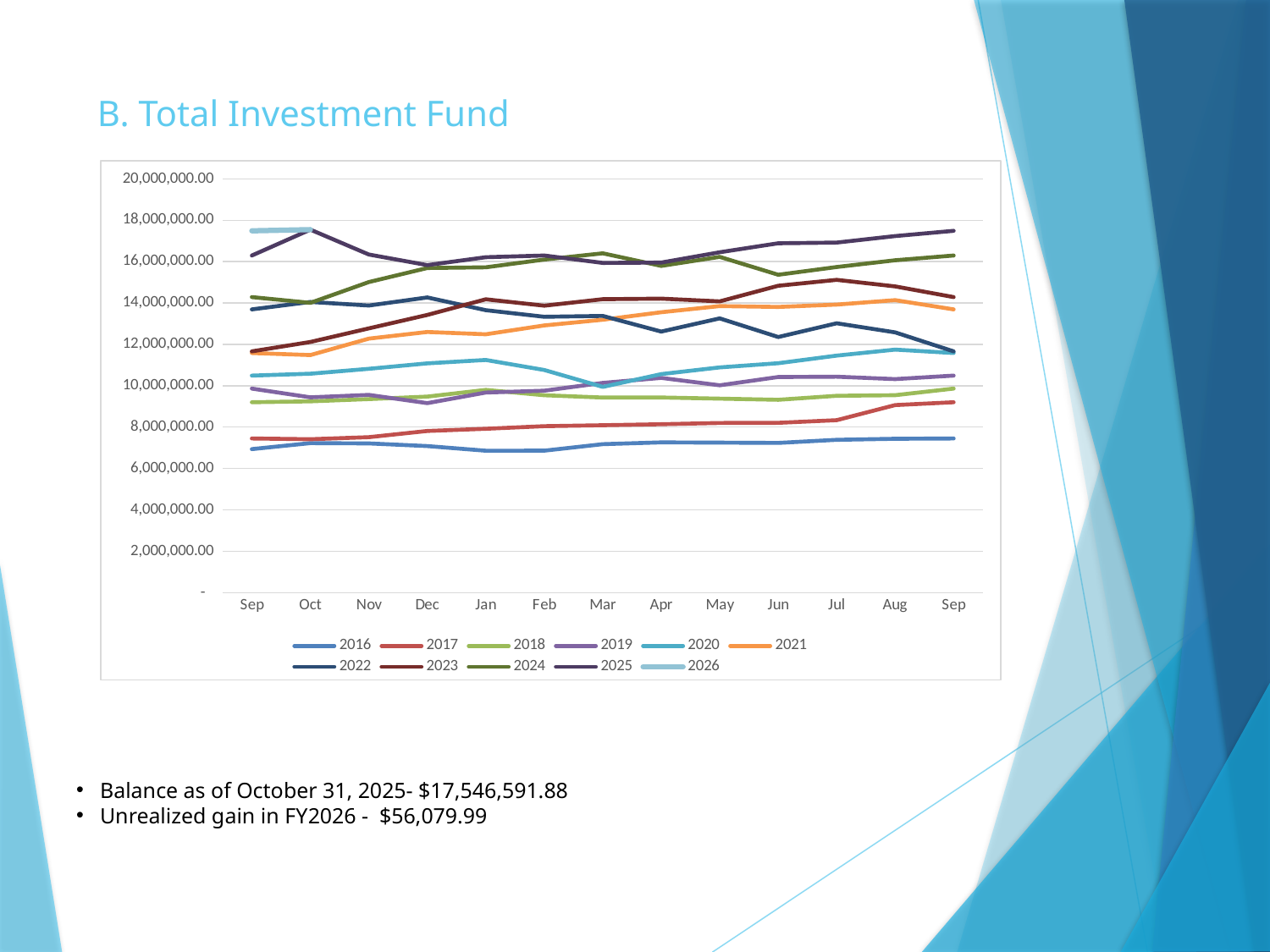
Is the value for 2017 at the first Sep greater or less than 8,000,000.00? less Is the value for 2016 at the first Sep greater or less than 8,000,000.00? less How many series does the legend list? 11 Is the value for 2024 at Jun greater or less than 14,000,000.00? greater At Dec, which series has the higher value, 2021 or 2020? 2021 Does the 2017 line rise or fall from the first Sep to the final Sep? rise What kind of chart is shown on the slide? line chart Which series has the lowest value at the first Sep? 2016 At Jan, which series has the higher value, 2025 or 2016? 2025 Which series has the highest value at the final Sep? 2025 How many month labels are on the x axis? 13